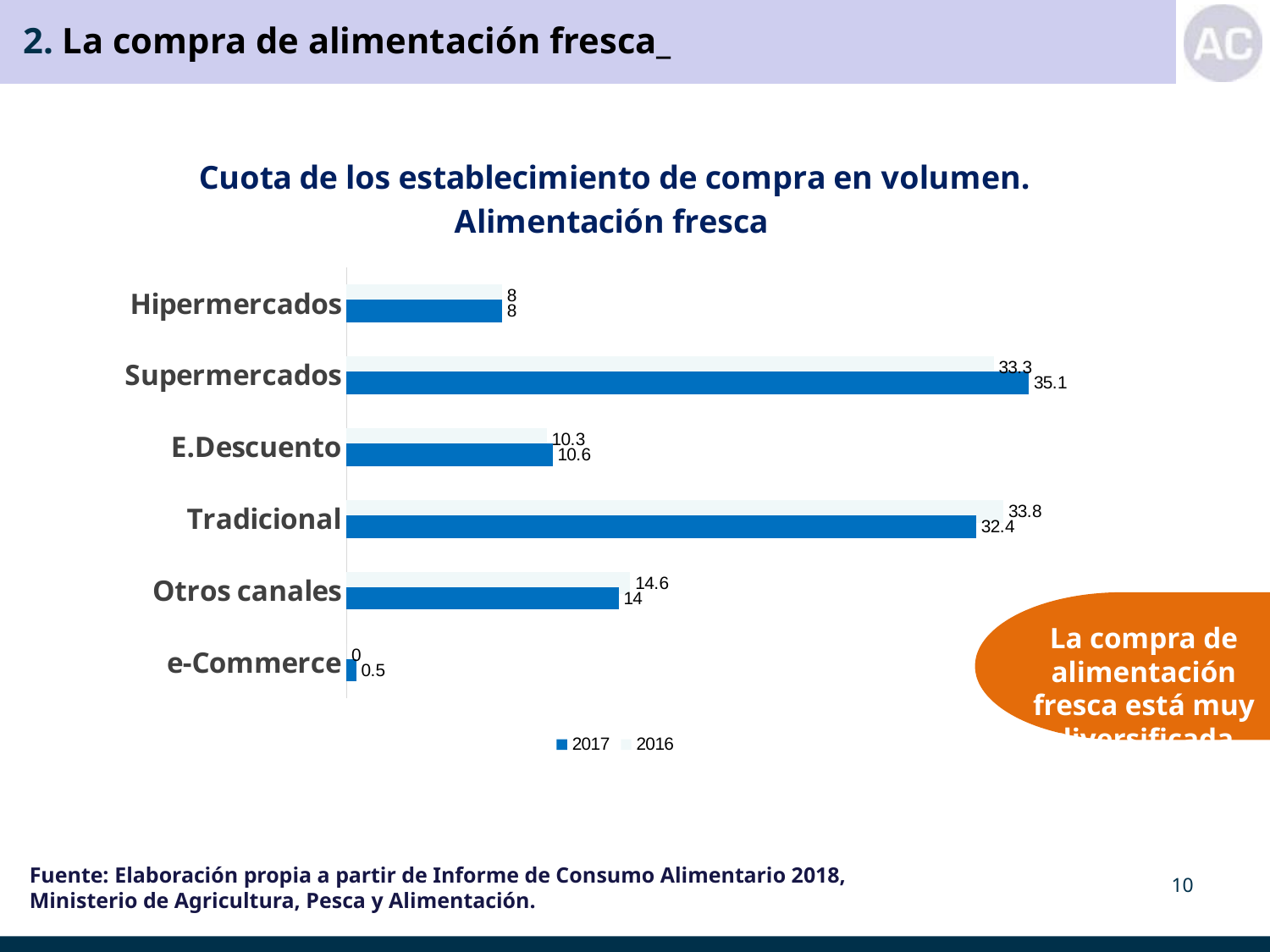
What is the difference between the 2017 and 2016 values for Supermercados? 1.8 What is the 2017 value for e-Commerce? 0.5 Which category has the lowest 2016 value? e-Commerce How many categories are shown on the chart? 6 Which category has the highest 2017 value? Supermercados Which is larger for Tradicional, the 2017 value or the 2016 value? 2016 How many series does the legend list? 2 What is the 2016 value for Otros canales? 14.6 What is the 2016 value for Tradicional? 33.8 What is the title of the chart? Cuota de los establecimiento de compra en volumen. Alimentación fresca What kind of chart is shown on the slide? Bar chart What is the 2017 value for Supermercados? 35.1